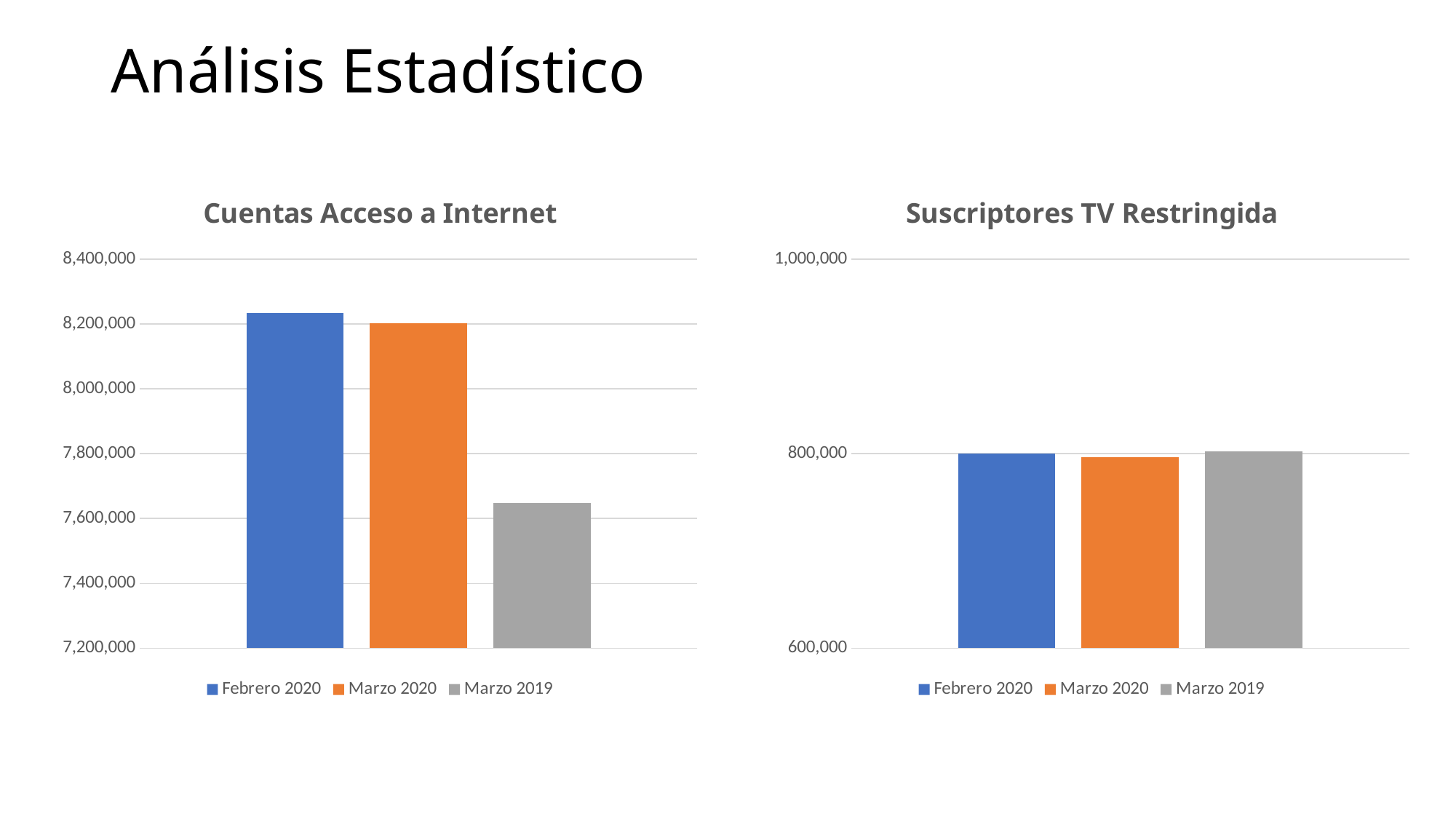
In the 'Cuentas Acceso a Internet' chart, which series has the lowest value? Marzo 2019 In the 'Suscriptores TV Restringida' chart, how many series does the legend list? 3 What kind of chart is the 'Cuentas Acceso a Internet' chart? bar chart What kind of chart is the 'Suscriptores TV Restringida' chart? bar chart What is the title of the chart on the right side of the slide? Suscriptores TV Restringida In the 'Suscriptores TV Restringida' chart, is the value for Marzo 2019 greater or less than 600,000? greater In the 'Cuentas Acceso a Internet' chart, is the value for Marzo 2020 greater or less than 8,000,000? greater In the 'Cuentas Acceso a Internet' chart, which is larger: Febrero 2020 or Marzo 2019? Febrero 2020 In the 'Cuentas Acceso a Internet' chart, how many series does the legend list? 3 In the 'Cuentas Acceso a Internet' chart, is the value for Marzo 2019 greater or less than 7,800,000? less